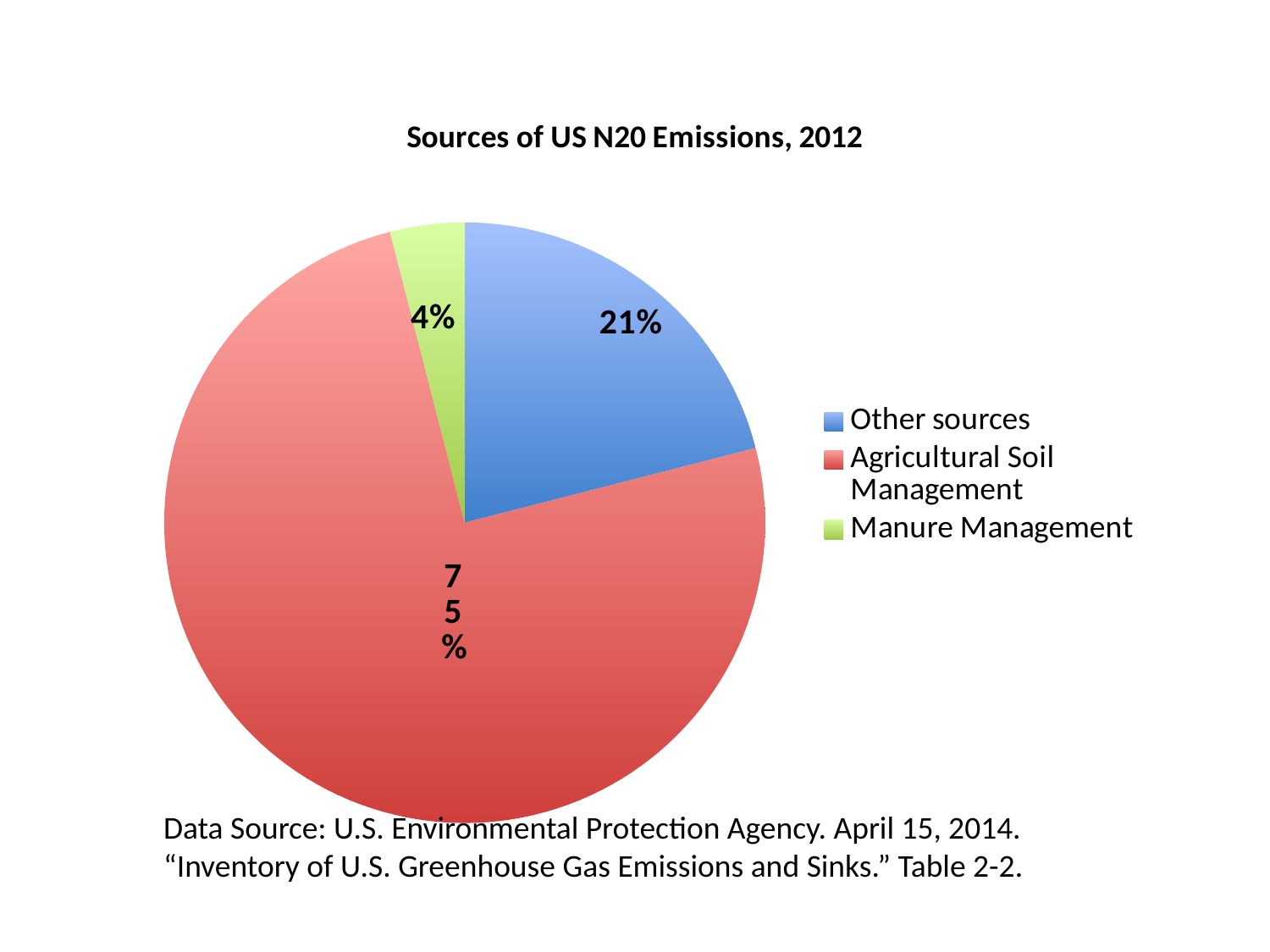
What is the title of the chart? Sources of US N20 Emissions, 2012 How many entries does the legend list? 3 What colour is the slice for Manure Management? green Which source has the largest share of US N2O emissions? Agricultural Soil Management What share of US N2O emissions comes from Other sources? 21% What kind of chart is shown on the slide? pie chart Which is larger, the share for Other sources or the share for Manure Management? Other sources What is the difference in percentage points between Agricultural Soil Management and Other sources? 54 How many slices does the pie chart have? 3 What share of US N2O emissions comes from Agricultural Soil Management? 75% Which source has the smallest share of US N2O emissions? Manure Management What share of US N2O emissions comes from Manure Management? 4%